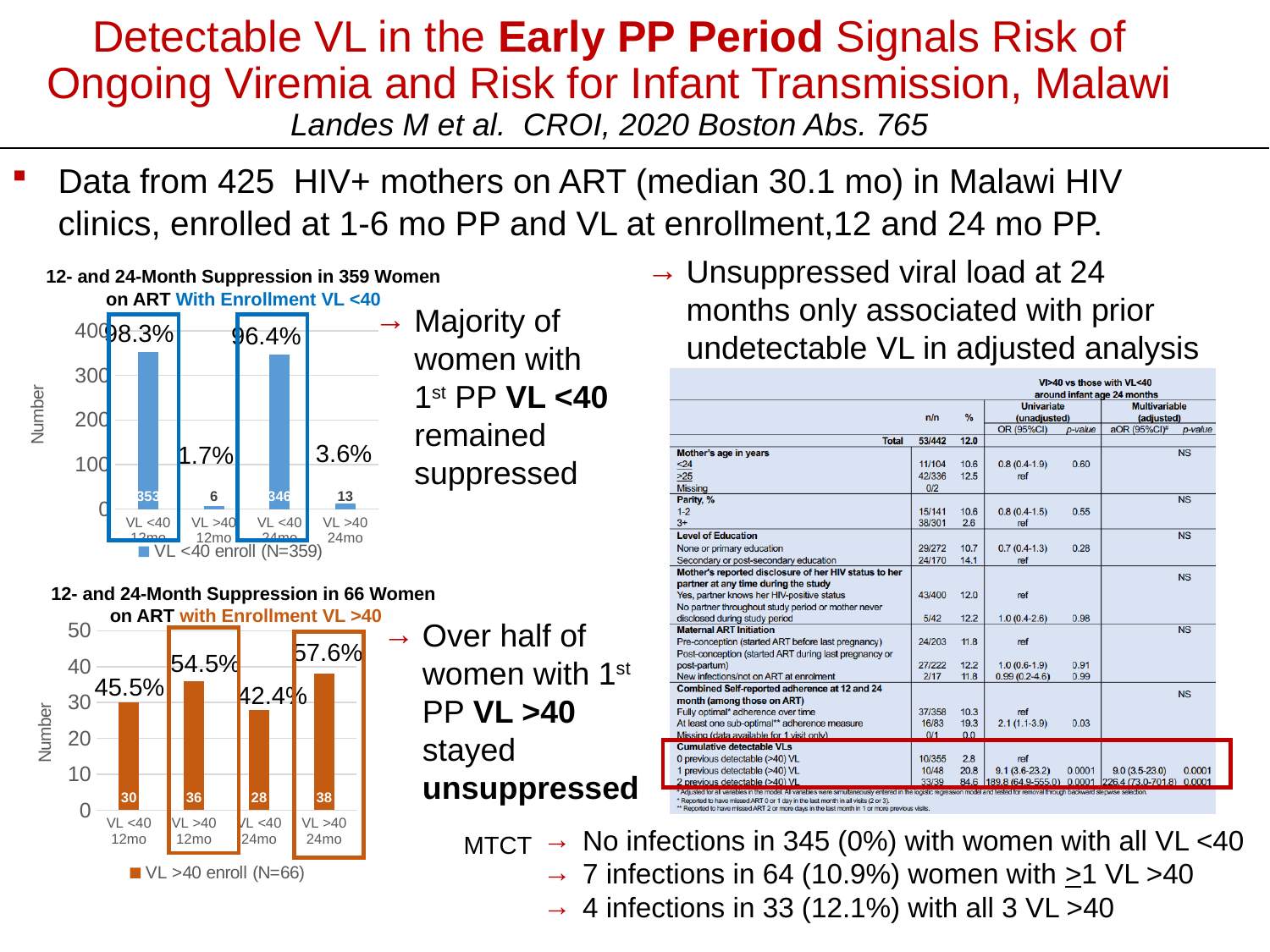
In the top chart (359 women with enrollment VL <40), which category has the lowest number? VL >40 12mo In the bottom chart (66 women with enrollment VL >40), what is the difference between the number with VL >40 at 12 months and the number with VL <40 at 12 months? 6 In the top chart (359 women with enrollment VL <40), what is the number of women with VL >40 at 24 months? 13 In the bottom chart (66 women with enrollment VL >40), which is larger: the number with VL <40 at 24 months or the number with VL >40 at 24 months? VL >40 24mo What type of chart is the top chart (359 women with enrollment VL <40)? Bar chart In the bottom chart (66 women with enrollment VL >40), what is the number of women with VL >40 at 24 months? 38 How many categories are plotted in the bottom chart (66 women with enrollment VL >40)? 4 In the bottom chart (66 women with enrollment VL >40), what percentage is shown for VL <40 at 12 months? 45.5% In the top chart (359 women with enrollment VL <40), what is the number of women with VL <40 at 12 months? 353 In the bottom chart (66 women with enrollment VL >40), which category has the highest number? VL >40 24mo In the top chart (359 women with enrollment VL <40), what is the difference between the number with VL <40 at 12 months and the number with VL <40 at 24 months? 7 In the top chart (359 women with enrollment VL <40), what percentage is shown for VL <40 at 24 months? 96.4%